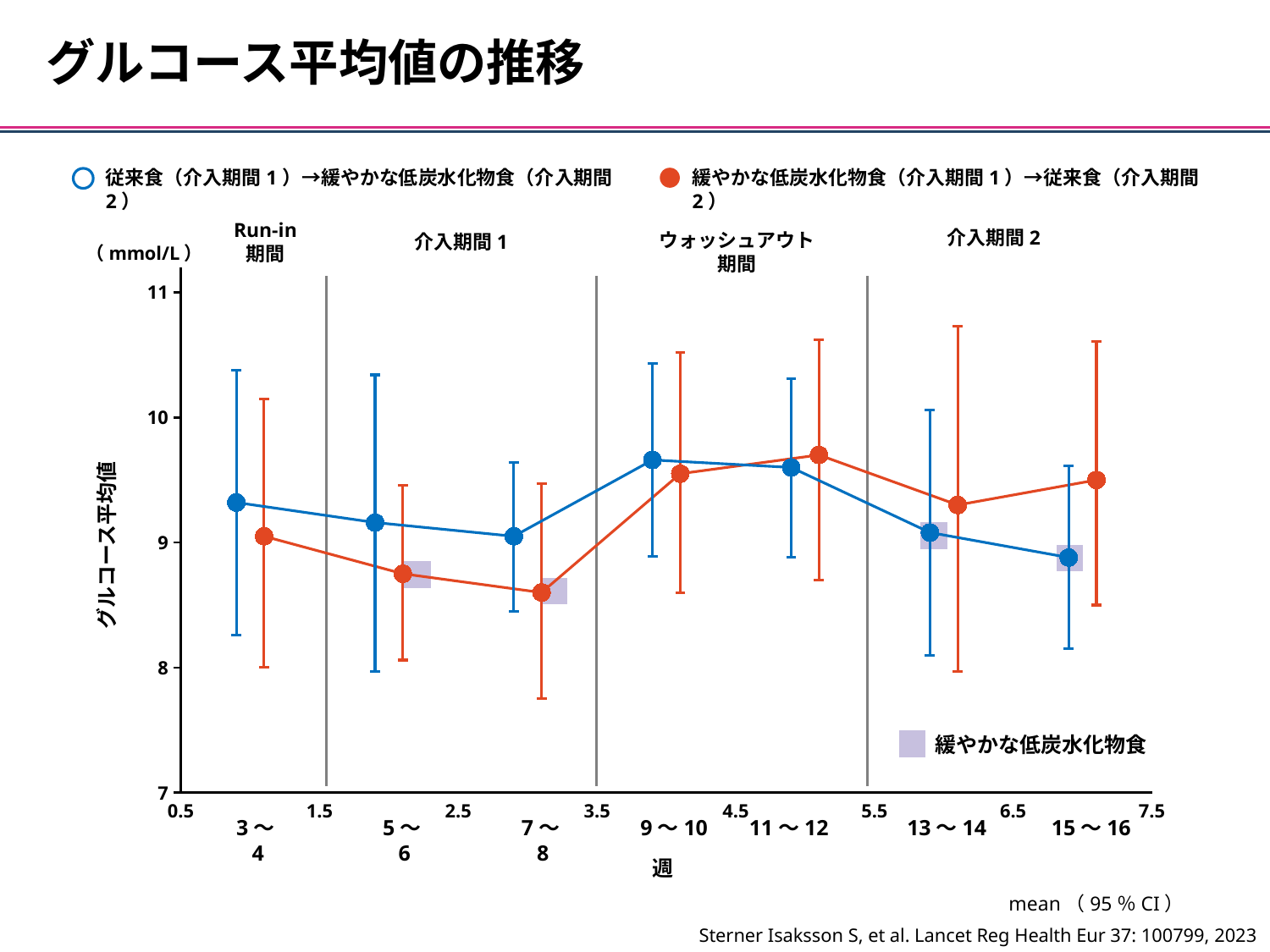
Is the value for the red series at weeks 15～16 greater or less than 9? greater What unit is shown for the y axis? mmol/L Does the blue series rise or fall from weeks 9～10 to weeks 15～16? fall At weeks 15～16, which series has the higher glucose mean, the blue series or the red series? the red series Is the value for the red series (緩やかな低炭水化物食→従来食) at weeks 7～8 greater or less than 9? less Is the value for the blue series (従来食→緩やかな低炭水化物食) at weeks 3～4 greater or less than 9? greater How many week categories are plotted along the x axis? 7 How many series does the legend list? 2 What kind of chart is shown on the slide? line chart At which week category does the blue series reach its lowest value? 15～16 At weeks 5～6, which series has the higher glucose mean, the blue series or the red series? the blue series At which week category does the red series reach its lowest value? 7～8